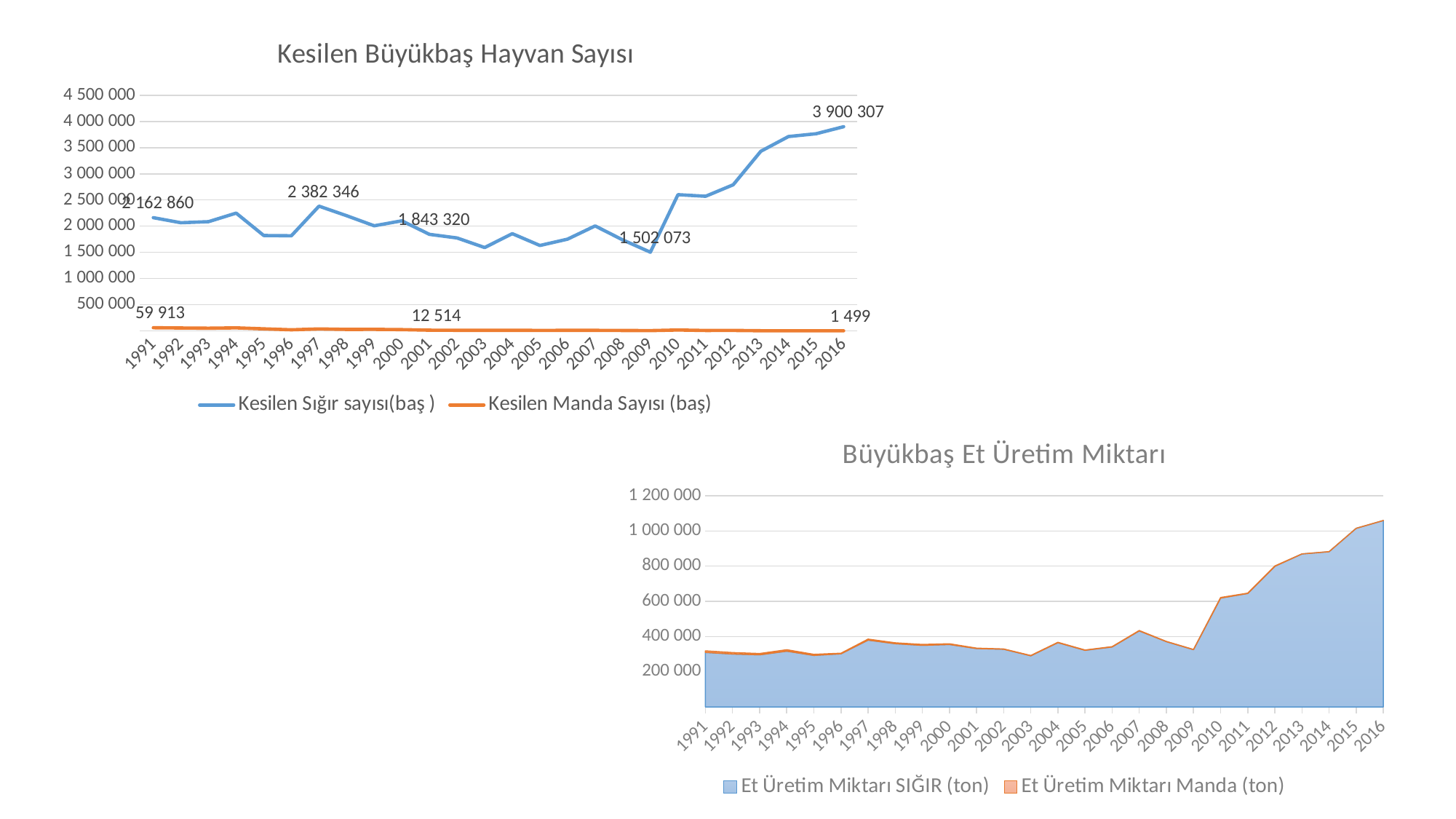
In the chart 'Kesilen Büyükbaş Hayvan Sayısı', what is the value of Kesilen Sığır sayısı(baş ) in 2016? 3 900 307 In the chart 'Büyükbaş Et Üretim Miktarı', is the value for Et Üretim Miktarı SIĞIR (ton) in 2016 greater or less than 1 000 000? greater In the chart 'Büyükbaş Et Üretim Miktarı', do the values rise or fall from 2009 to 2016? Rise In the chart 'Kesilen Büyükbaş Hayvan Sayısı', what is the value of Kesilen Manda Sayısı (baş) in 2016? 1 499 In the chart 'Kesilen Büyükbaş Hayvan Sayısı', what is the value of Kesilen Manda Sayısı (baş) in 1991? 59 913 In the chart 'Kesilen Büyükbaş Hayvan Sayısı', what is the difference between the Kesilen Manda Sayısı (baş) values for 1991 and 2016? 58 414 In the chart 'Kesilen Büyükbaş Hayvan Sayısı', by how much did Kesilen Sığır sayısı(baş ) increase from 1991 to 2016? 1 737 447 In the chart 'Kesilen Büyükbaş Hayvan Sayısı', which year has the higher Kesilen Sığır sayısı(baş ) value, 1997 or 2000? 1997 How many years are shown on the x axis of the chart 'Kesilen Büyükbaş Hayvan Sayısı'? 26 How many series does the legend of the chart 'Kesilen Büyükbaş Hayvan Sayısı' list? 2 In the chart 'Kesilen Büyükbaş Hayvan Sayısı', what is the value of Kesilen Sığır sayısı(baş ) in 2009? 1 502 073 What kind of chart is 'Büyükbaş Et Üretim Miktarı'? Area chart